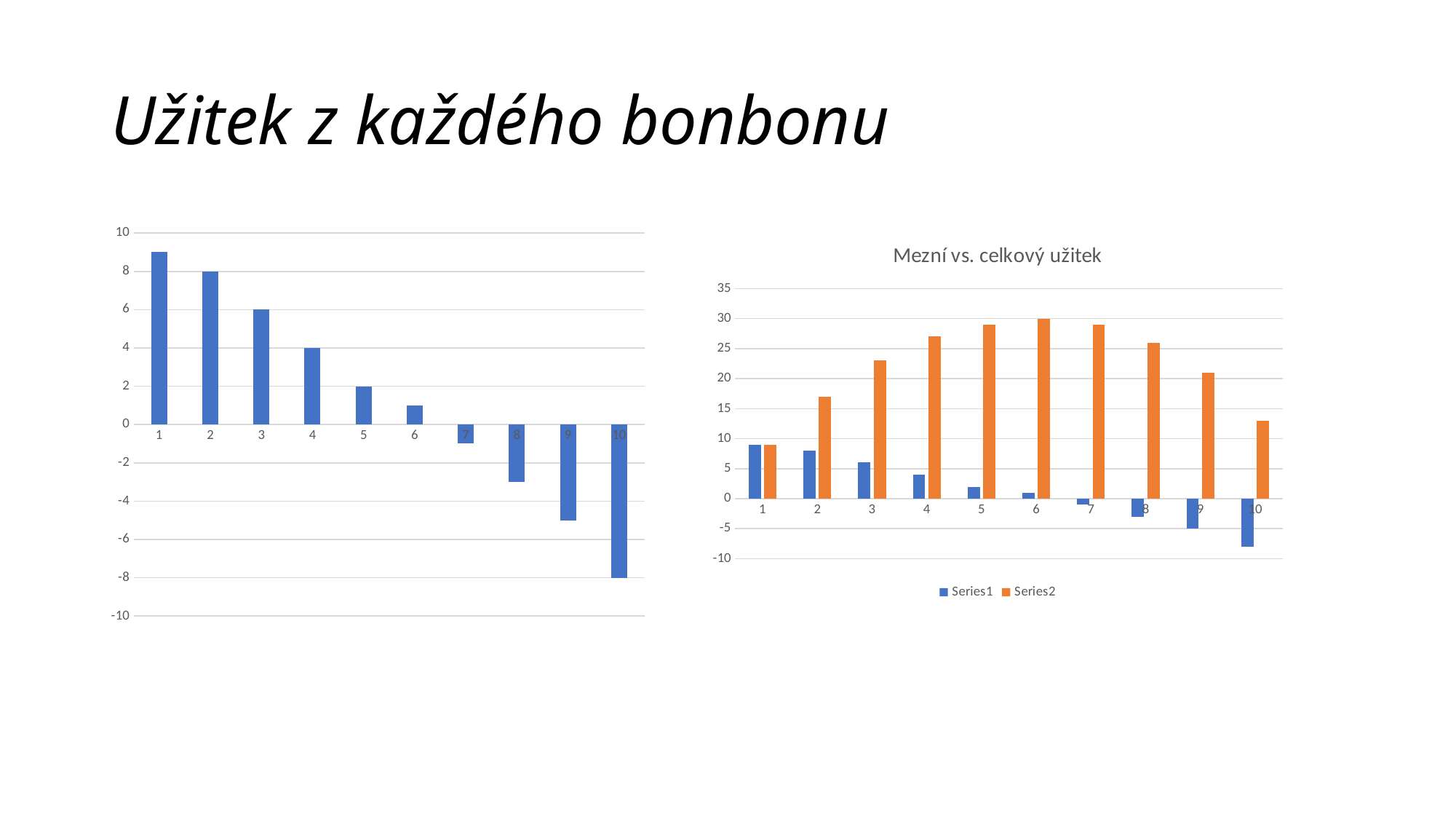
In the chart titled 'Mezní vs. celkový užitek', which category has the highest Series2 value? 6 In the chart on the left, what is the value for category 10? -8 In the chart titled 'Mezní vs. celkový užitek', how many series does the legend list? 2 In the chart on the left, do the values rise or fall as you move from category 1 to category 10? fall In the chart on the left, which category has the highest value? 1 What kind of chart is the chart on the left of the slide? bar chart In the chart on the left, how many categories are shown on the x axis? 10 In the chart titled 'Mezní vs. celkový užitek', which is larger at category 4: Series1 or Series2? Series2 In the chart on the left, what is the value for category 2? 8 What is the title of the chart on the right? Mezní vs. celkový užitek In the chart titled 'Mezní vs. celkový užitek', is the Series2 value for category 3 greater or less than 20? greater In the chart on the left, which category has the lowest value? 10